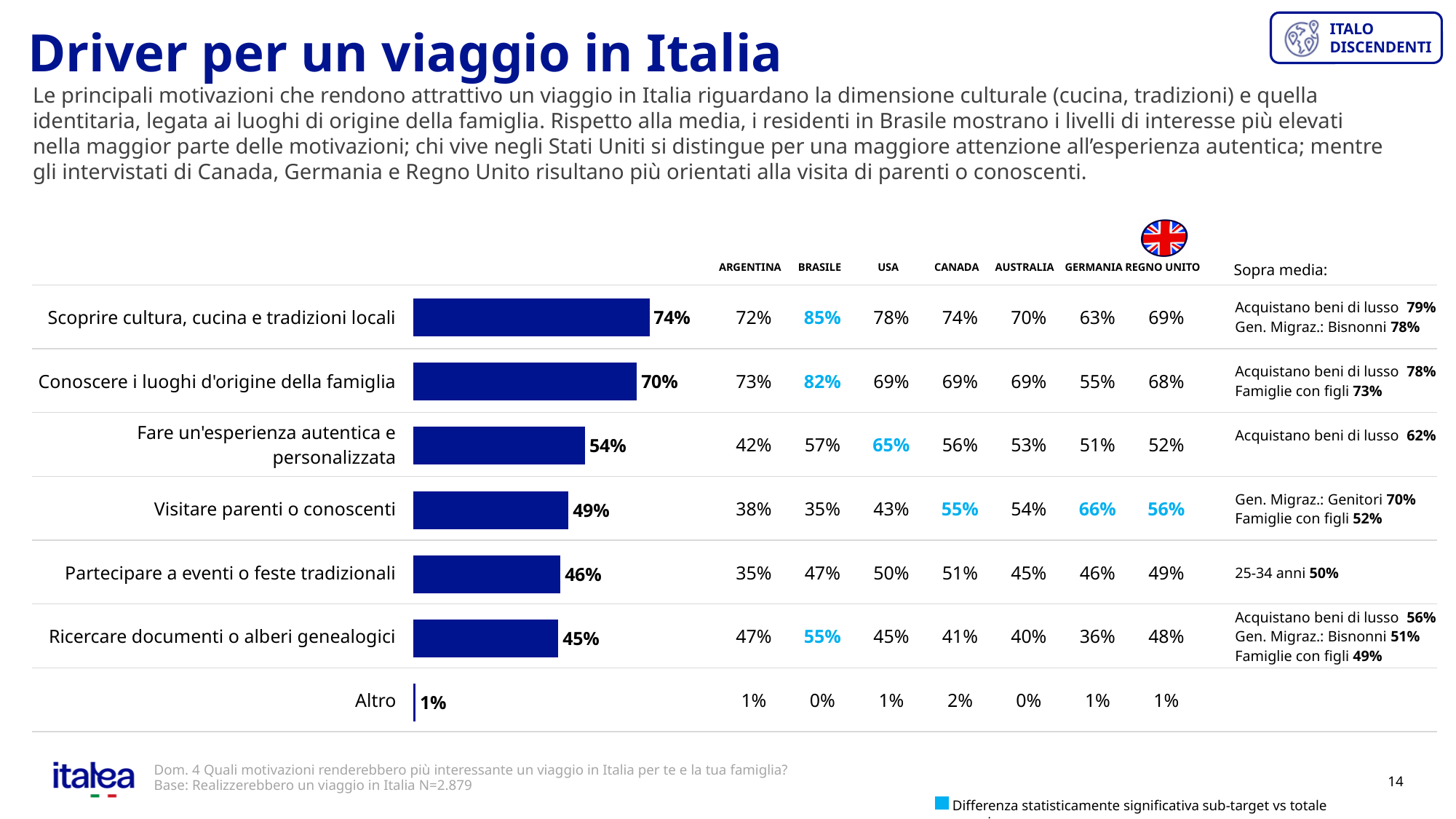
In the bar chart, which has a larger value: "Partecipare a eventi o feste tradizionali" or "Ricercare documenti o alberi genealogici"? Partecipare a eventi o feste tradizionali What kind of chart is used on this slide? Bar chart Which category has the lowest value in the bar chart? Altro What is the difference between the values for "Visitare parenti o conoscenti" and "Altro" in the bar chart? 48 percentage points What colour are the bars in the chart? Dark blue How many categories are shown in the bar chart? 7 Do the bar values rise or fall going from the top category to the bottom category? Fall What is the value shown for "Fare un'esperienza autentica e personalizzata" in the bar chart? 54% What is the value shown for "Visitare parenti o conoscenti" in the bar chart? 49% Which category has the highest value in the bar chart? Scoprire cultura, cucina e tradizioni locali What is the value shown for "Scoprire cultura, cucina e tradizioni locali" in the bar chart? 74% What is the difference between the values for "Scoprire cultura, cucina e tradizioni locali" and "Conoscere i luoghi d'origine della famiglia" in the bar chart? 4 percentage points